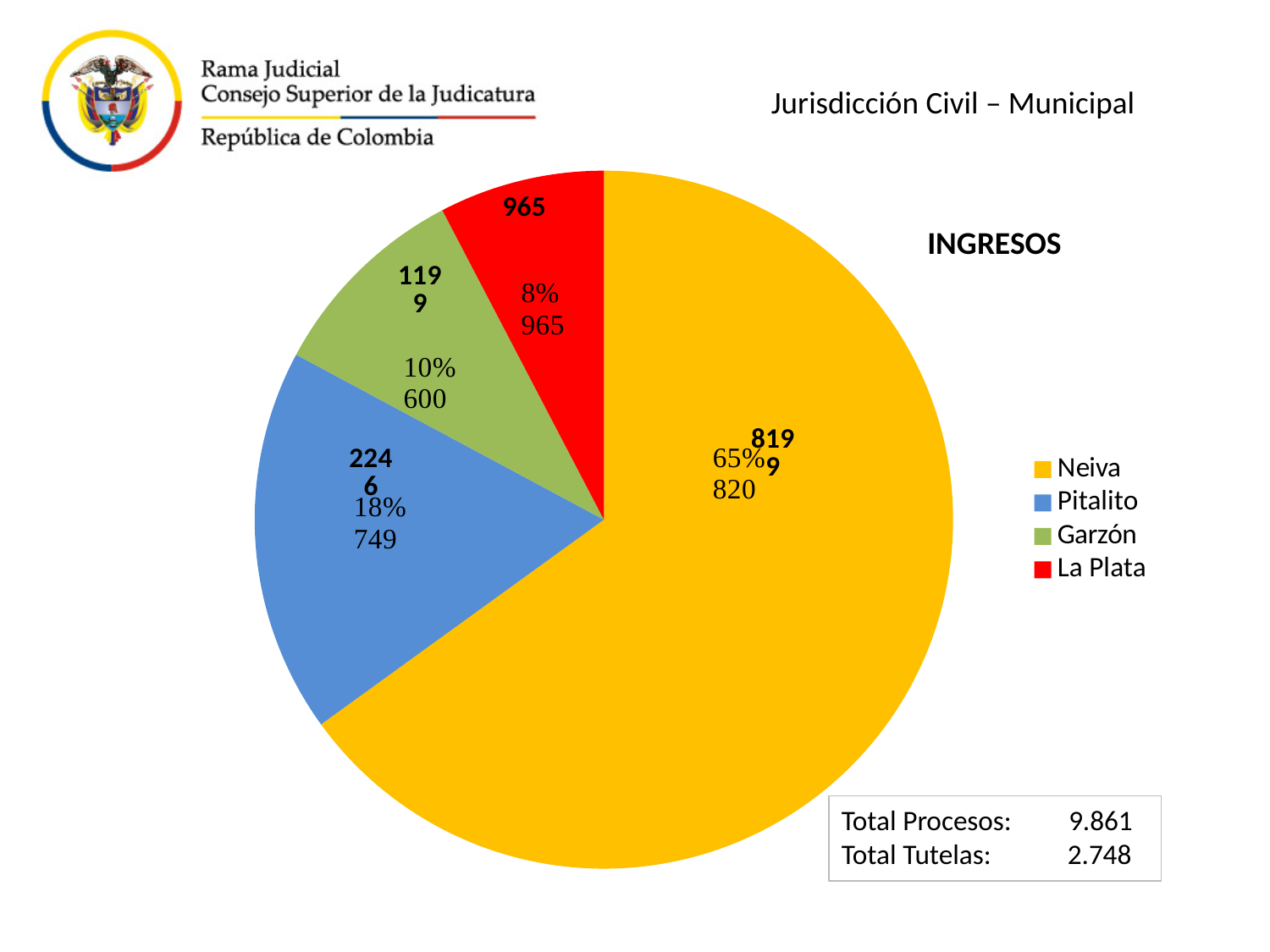
Which category has the largest slice of the pie? Neiva What colour is the slice for La Plata? red What is the value shown for Garzón? 1199 Which slice is larger, Pitalito or Garzón? Pitalito What percentage share of the pie does Neiva have? 65% What is the title of the chart? INGRESOS What is the value shown for Pitalito? 2246 What percentage share of the pie does La Plata have? 8% What is the value shown for La Plata? 965 Which category has the smallest slice of the pie? La Plata How many categories does the legend of the pie chart list? 4 What kind of chart is shown on the slide? pie chart